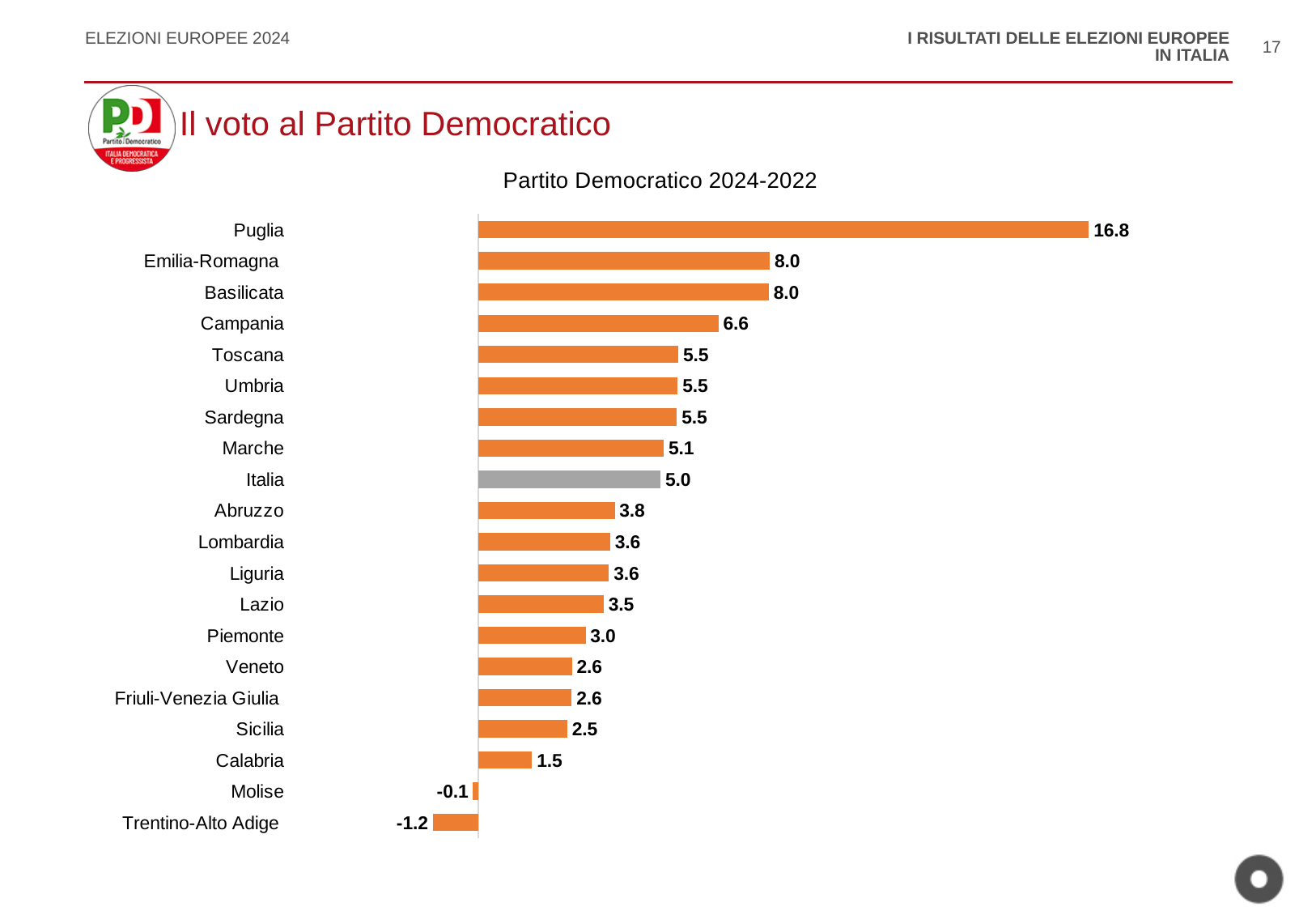
What is the difference between the values for Puglia and Emilia-Romagna? 8.8 What kind of chart is shown on the slide? Bar chart What is the title of the chart? Partito Democratico 2024-2022 Which region has the lowest value? Trentino-Alto Adige Which region has the highest value? Puglia What is the value for Italia? 5.0 How many regions (categories) are shown in the chart? 20 Which is larger, the value for Abruzzo or the value for Piemonte? Abruzzo What is the value for Puglia? 16.8 What is the value for Campania? 6.6 What is the value for Trentino-Alto Adige? -1.2 What is the difference between the values for Campania and Italia? 1.6